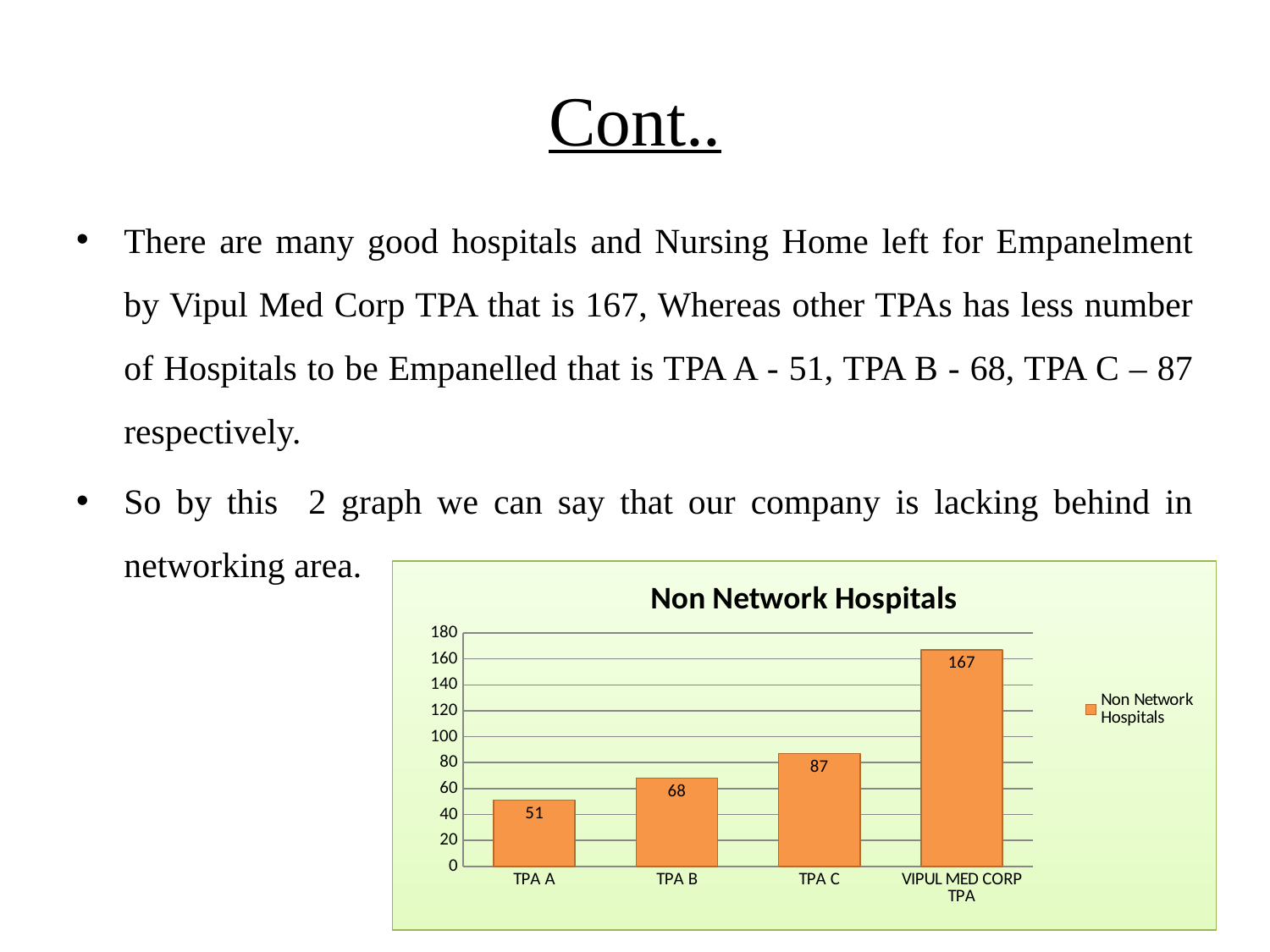
How many categories are shown on the x axis of the chart? 4 What is the difference between the values for TPA B and TPA A? 17 What is the value for VIPUL MED CORP TPA in the Non Network Hospitals chart? 167 Is the value for VIPUL MED CORP TPA greater or less than 160? greater Which is larger, the value for TPA B or the value for TPA C? TPA C Which category has the lowest value in the Non Network Hospitals chart? TPA A What is the title of the chart on the slide? Non Network Hospitals What kind of chart is shown on the slide? bar chart Which category has the highest value in the Non Network Hospitals chart? VIPUL MED CORP TPA What is the value for TPA C in the Non Network Hospitals chart? 87 What is the value for TPA A in the Non Network Hospitals chart? 51 What is the difference between the values for VIPUL MED CORP TPA and TPA C? 80